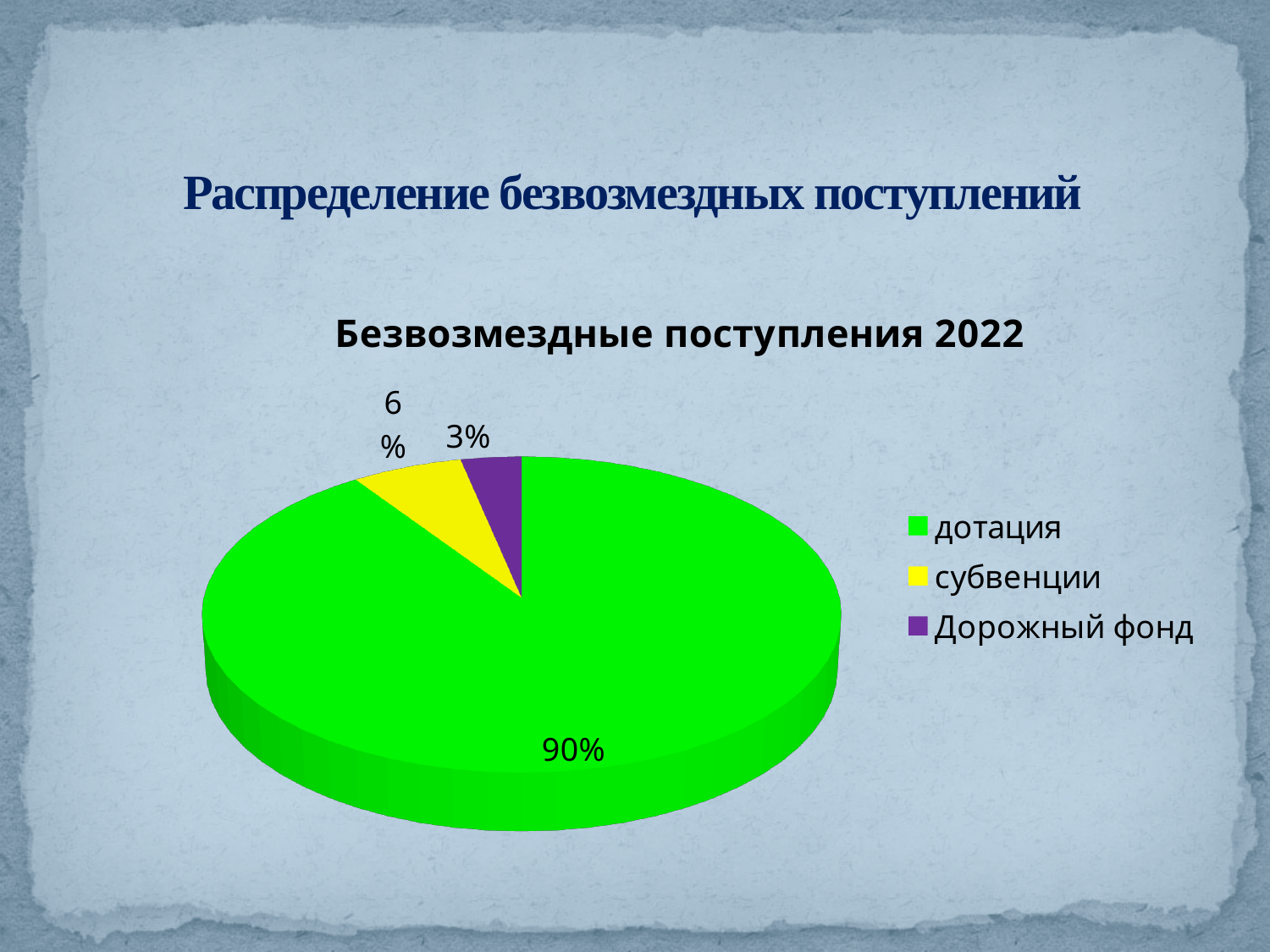
What is the difference in percentage points between дотация and субвенции? 84 What kind of chart is shown on the slide? pie chart What share of the pie does дотация have? 90% What share of the pie does субвенции have? 6% Which category has the smallest slice? Дорожный фонд Which category has the largest slice? дотация Which is larger, the slice for субвенции or the slice for Дорожный фонд? субвенции What is the difference in percentage points between субвенции and Дорожный фонд? 3 What share of the pie does Дорожный фонд have? 3% What colour is the slice for Дорожный фонд? purple What is the chart's title? Безвозмездные поступления 2022 How many categories does the legend list? 3